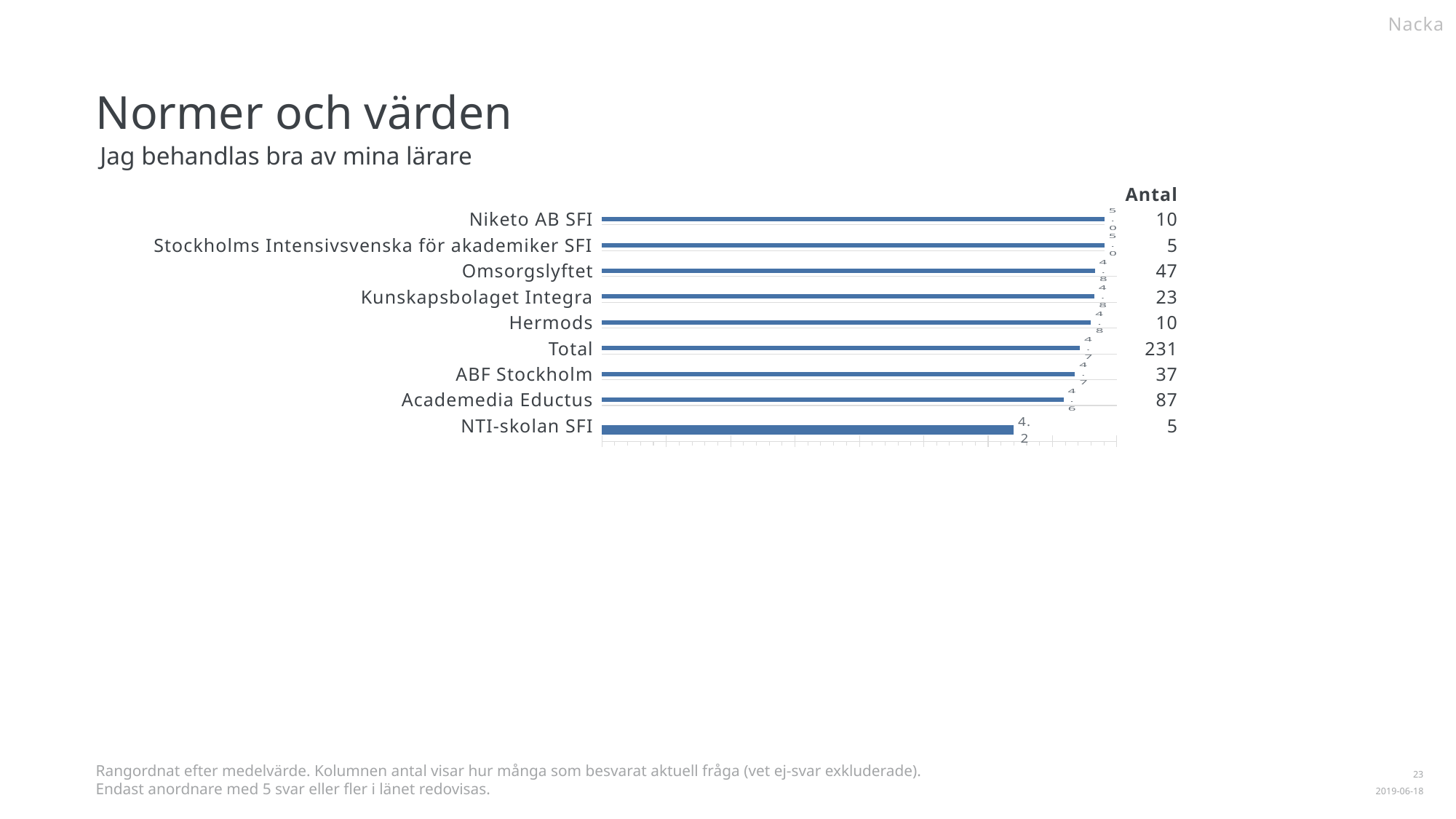
What is the value for Academedia Eductus? 4.6 Which category has the lowest value? NTI-skolan SFI What is the value for NTI-skolan SFI? 4.2 What is the value for Total? 4.7 What is the difference between the values for Niketo AB SFI and NTI-skolan SFI? 0.8 What type of chart is shown on the slide? bar chart What is the Antal (number of respondents) shown for Academedia Eductus? 87 Which has a larger value, Omsorgslyftet or Academedia Eductus? Omsorgslyftet What is the value for Niketo AB SFI? 5.0 What is the subtitle (question statement) shown above the chart? Jag behandlas bra av mina lärare How many categories (providers) are shown in the chart? 9 What is the Antal (number of respondents) shown for Total? 231